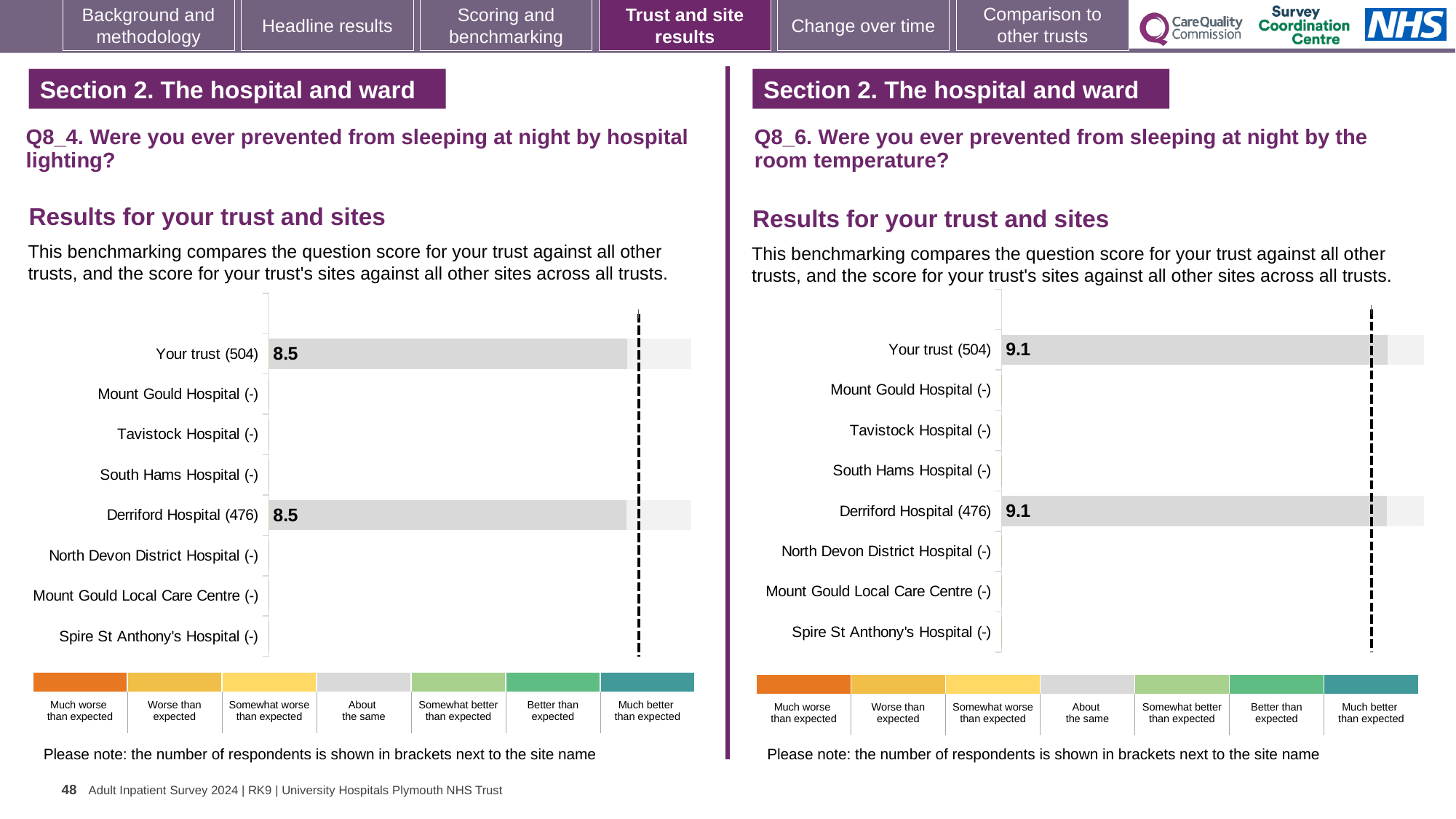
On the right chart (Q8_6, room temperature), what is the difference between the scores for Your trust (504) and Derriford Hospital (476)? 0 How many site categories are listed on the right chart (Q8_6, room temperature)? 8 On the right chart (Q8_6, room temperature), how many respondents are shown in brackets for Your trust? 504 On the left chart (Q8_4, hospital lighting), how many respondents are shown in brackets for Derriford Hospital? 476 On the right chart (Q8_6, room temperature), what is the score for Your trust (504)? 9.1 On the left chart (Q8_4, hospital lighting), what is the difference between the scores for Your trust (504) and Derriford Hospital (476)? 0 On the right chart (Q8_6, room temperature), what is the score for Derriford Hospital (476)? 9.1 On the left chart (Q8_4, hospital lighting), what is the score for Your trust (504)? 8.5 What kind of chart is used on the left (Q8_4, hospital lighting)? Bar chart On the left chart (Q8_4, hospital lighting), what is the score for Derriford Hospital (476)? 8.5 How many benchmark categories does the colour legend below the left chart (Q8_4, hospital lighting) show? 7 How many site categories are listed on the left chart (Q8_4, hospital lighting)? 8